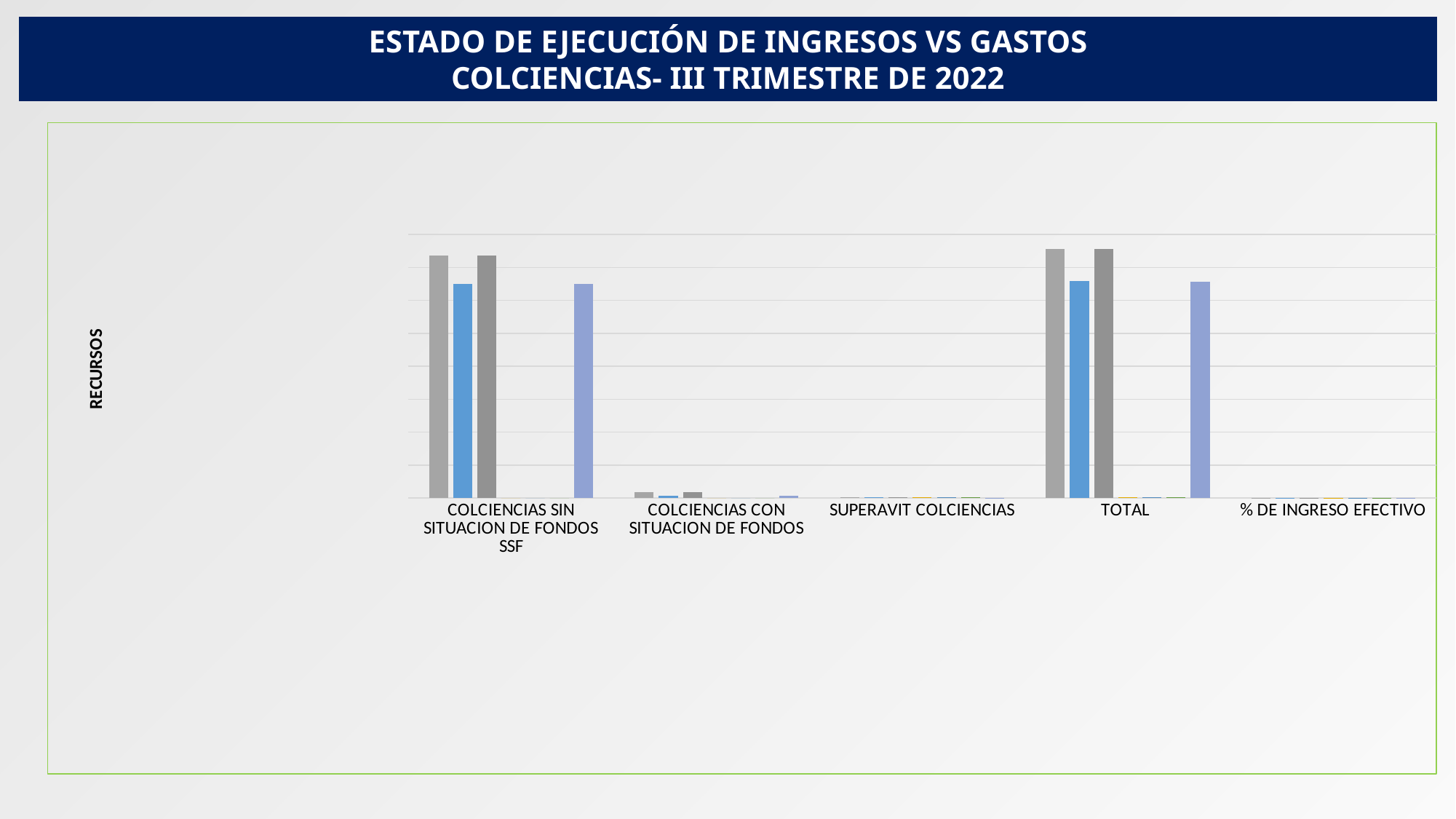
What kind of chart is shown on the slide? bar chart How many categories are shown on the x axis of the chart? 5 Which category has larger bars, TOTAL or COLCIENCIAS CON SITUACION DE FONDOS? TOTAL Which category has larger bars, COLCIENCIAS CON SITUACION DE FONDOS or % DE INGRESO EFECTIVO? COLCIENCIAS CON SITUACION DE FONDOS What is the title of the chart on the slide? ESTADO DE EJECUCIÓN DE INGRESOS VS GASTOS COLCIENCIAS- III TRIMESTRE DE 2022 What is the label of the first category on the x axis? COLCIENCIAS SIN SITUACION DE FONDOS SSF What is the label on the vertical axis of the chart? RECURSOS What is the label of the last category on the x axis? % DE INGRESO EFECTIVO Which category has larger bars, COLCIENCIAS SIN SITUACION DE FONDOS SSF or SUPERAVIT COLCIENCIAS? COLCIENCIAS SIN SITUACION DE FONDOS SSF